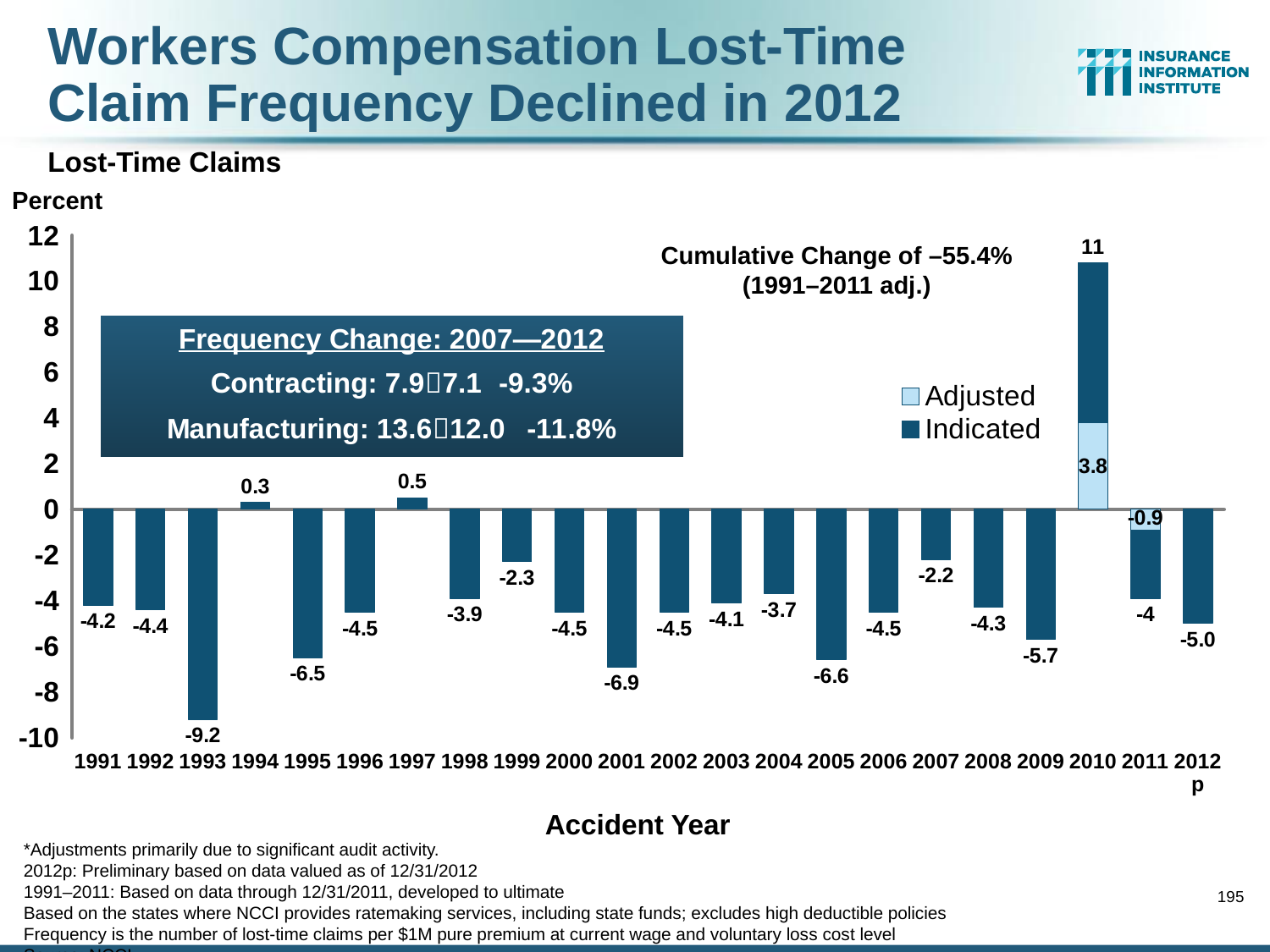
What is the value for 2012p? -5.0 What is the difference between the values for 2001 and 1999? 4.6 How many series does the legend list? 2 What is the Indicated value for 2010? 11 How many accident years are shown on the x axis? 22 Which accident year has the lowest value? 1993 What is the value for 1993? -9.2 What is the Adjusted value for 2011? -0.9 What kind of chart is shown? Bar chart Which is larger, the value for 1994 or the value for 1997? 1997 Which accident year has the highest Indicated value? 2010 What is the Adjusted value for 2010? 3.8